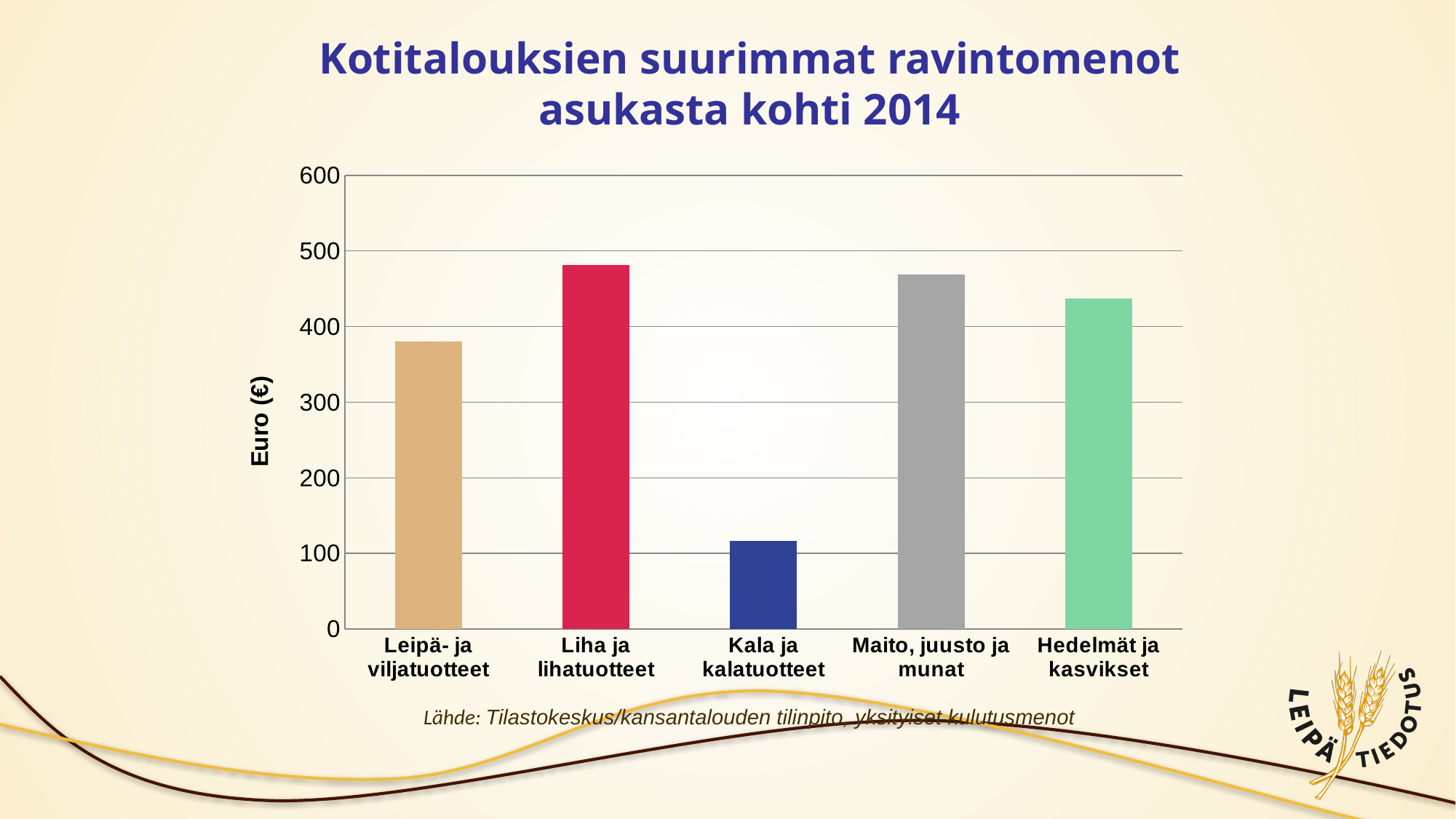
Is the value for Kala ja kalatuotteet greater or less than 200? less Is the value for Maito, juusto ja munat greater or less than 400? greater What is the label of the y axis of the chart? Euro (€) Is the value for Liha ja lihatuotteet greater or less than 500? less Which is larger, the value for Leipä- ja viljatuotteet or the value for Hedelmät ja kasvikset? Hedelmät ja kasvikset How many categories are shown on the x axis of the chart? 5 What kind of chart is shown on the slide? bar chart Which is larger, the value for Kala ja kalatuotteet or the value for Leipä- ja viljatuotteet? Leipä- ja viljatuotteet Which category has the lowest value in the chart? Kala ja kalatuotteet